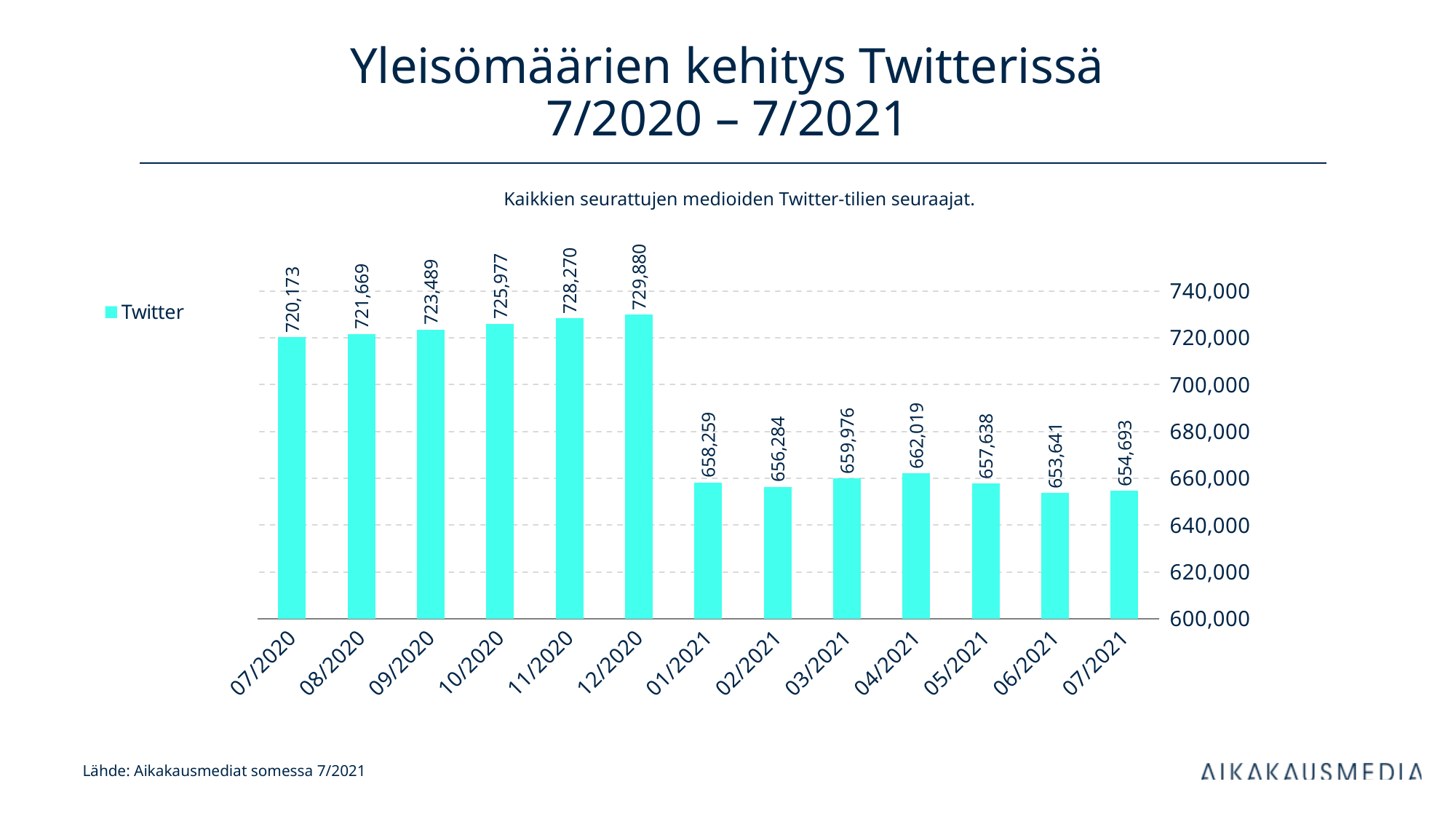
What is the value for 04/2021? 662,019 What series does the legend list? Twitter Which month has the lowest value? 06/2021 Which is larger, the value for 03/2021 or the value for 02/2021? 03/2021 How many months are shown on the x axis? 13 What is the difference between the values for 07/2020 and 07/2021? 65,480 What is the difference between the values for 12/2020 and 01/2021? 71,621 What is the value for 12/2020? 729,880 What kind of chart is shown on the slide? bar chart What is the value for 07/2020? 720,173 Is the value for 11/2020 greater or less than 700,000? greater Which month has the highest value? 12/2020